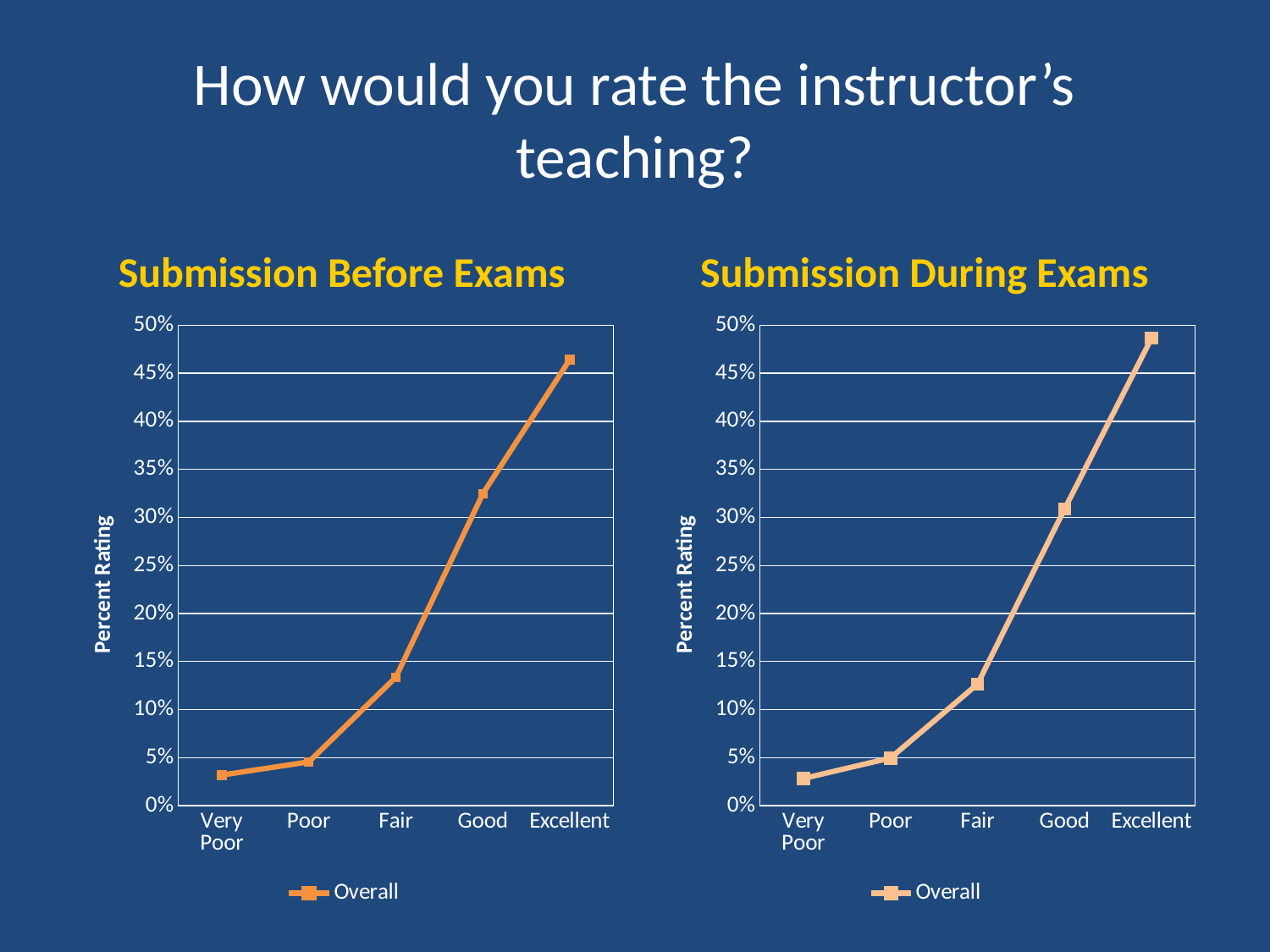
In the 'Submission Before Exams' chart, which is larger, the value for Fair or the value for Good? Good In the 'Submission During Exams' chart, is the value for Fair greater or less than 15%? less In the 'Submission During Exams' chart, is the value for Excellent greater or less than 45%? greater What is the name of the series shown in the legend of the 'Submission During Exams' chart? Overall In the 'Submission Before Exams' chart, is the value for Good greater or less than 30%? greater In the 'Submission Before Exams' chart, do the values rise or fall from Very Poor to Excellent? rise What is the y-axis title of the 'Submission Before Exams' chart? Percent Rating In the 'Submission Before Exams' chart, which rating category has the highest value? Excellent How many series does the legend of the 'Submission Before Exams' chart list? 1 How many rating categories are shown on the x axis of the 'Submission During Exams' chart? 5 In the 'Submission During Exams' chart, which rating category has the lowest value? Very Poor What kind of chart is the 'Submission Before Exams' chart? line chart